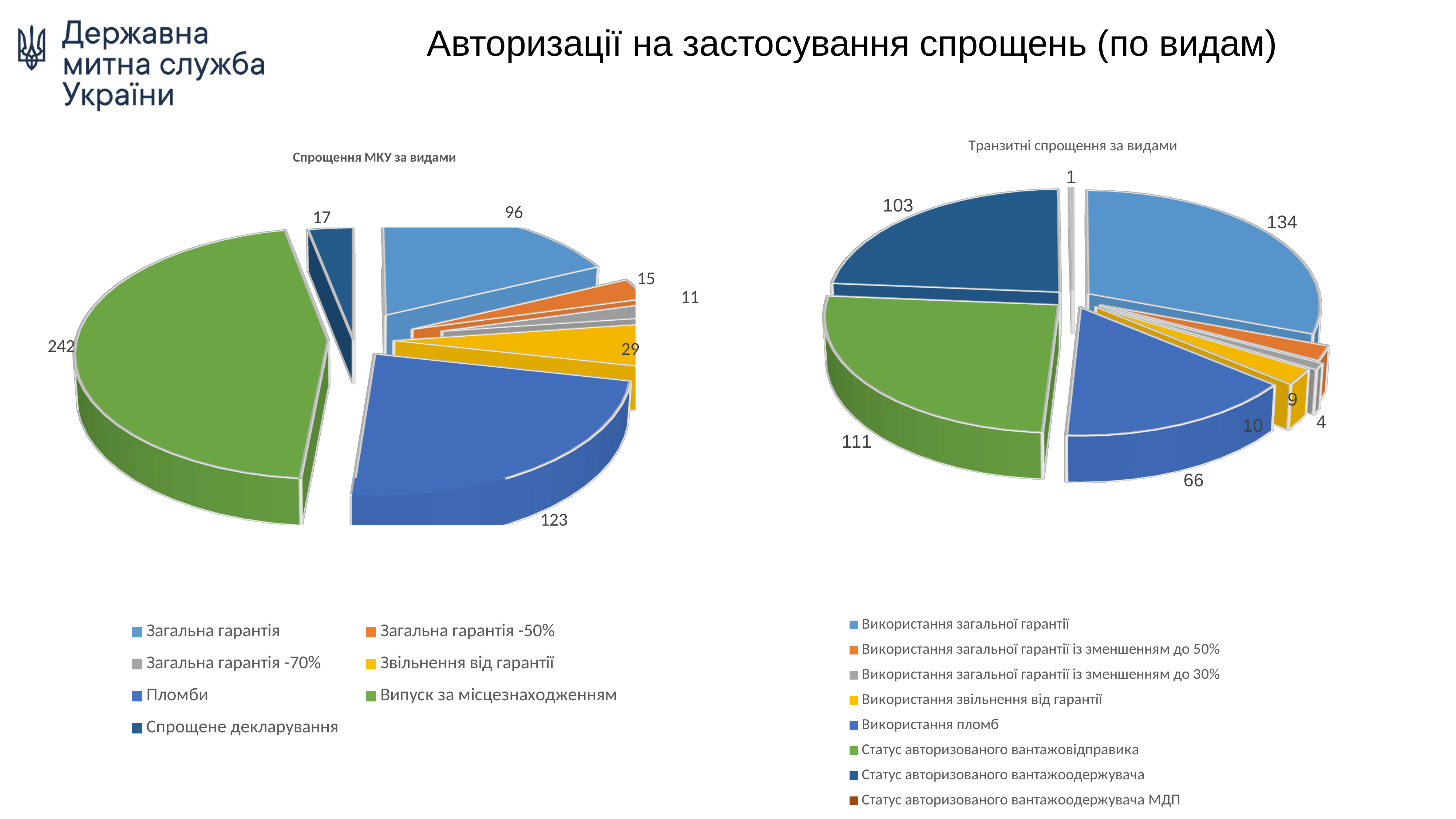
In the "Транзитні спрощення за видами" chart, which category has the smallest value? Статус авторизованого вантажоодержувача МДП In the "Спрощення МКУ за видами" chart, what is the value for Пломби? 123 In the "Транзитні спрощення за видами" chart, what is the value for Використання загальної гарантії? 134 What type of chart is "Спрощення МКУ за видами"? Pie chart How many categories does the legend of the "Транзитні спрощення за видами" chart list? 8 In the "Транзитні спрощення за видами" chart, what is the value for Статус авторизованого вантажоодержувача? 103 In the "Спрощення МКУ за видами" chart, which category has the largest value? Випуск за місцезнаходженням In the "Транзитні спрощення за видами" chart, which is larger: Статус авторизованого вантажовідправника or Використання пломб? Статус авторизованого вантажовідправника In the "Спрощення МКУ за видами" chart, what is the difference between Випуск за місцезнаходженням and Пломби? 119 In the "Спрощення МКУ за видами" chart, what is the value for Випуск за місцезнаходженням? 242 How many categories does the legend of the "Спрощення МКУ за видами" chart list? 7 In the "Спрощення МКУ за видами" chart, which category has the smallest value? Загальна гарантія -70%